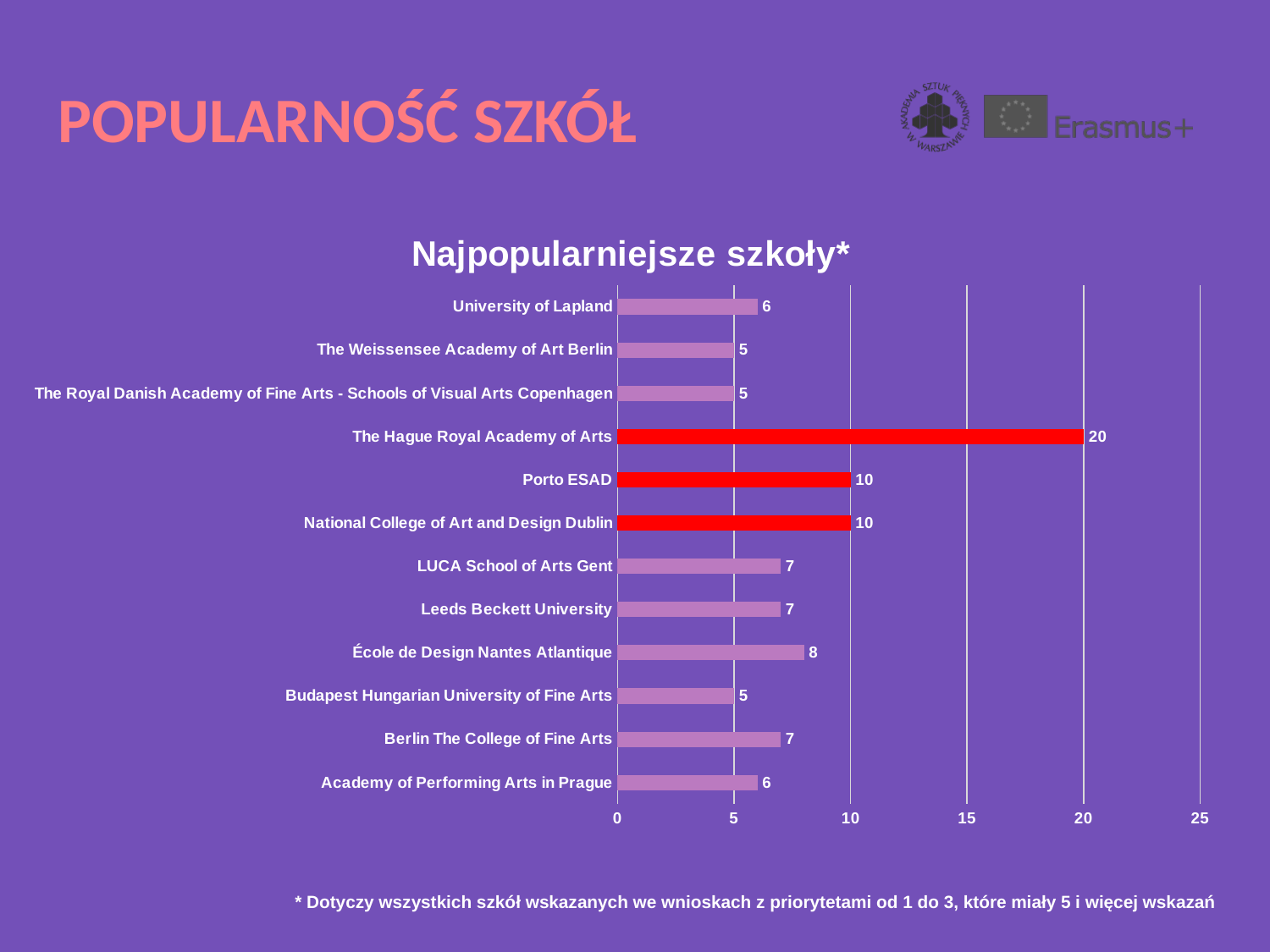
Is the value for National College of Art and Design Dublin greater or less than 5? greater What is the difference between the values for LUCA School of Arts Gent and Budapest Hungarian University of Fine Arts? 2 What is the value for The Hague Royal Academy of Arts? 20 What is the value for École de Design Nantes Atlantique? 8 Which school has the highest value? The Hague Royal Academy of Arts What is the value for University of Lapland? 6 What kind of chart is shown on the slide? bar chart Which has a larger value, École de Design Nantes Atlantique or Leeds Beckett University? École de Design Nantes Atlantique How many bars are coloured red? 3 What is the title of the chart? Najpopularniejsze szkoły* How many schools are shown in the chart? 12 What is the difference between the values for The Hague Royal Academy of Arts and Porto ESAD? 10